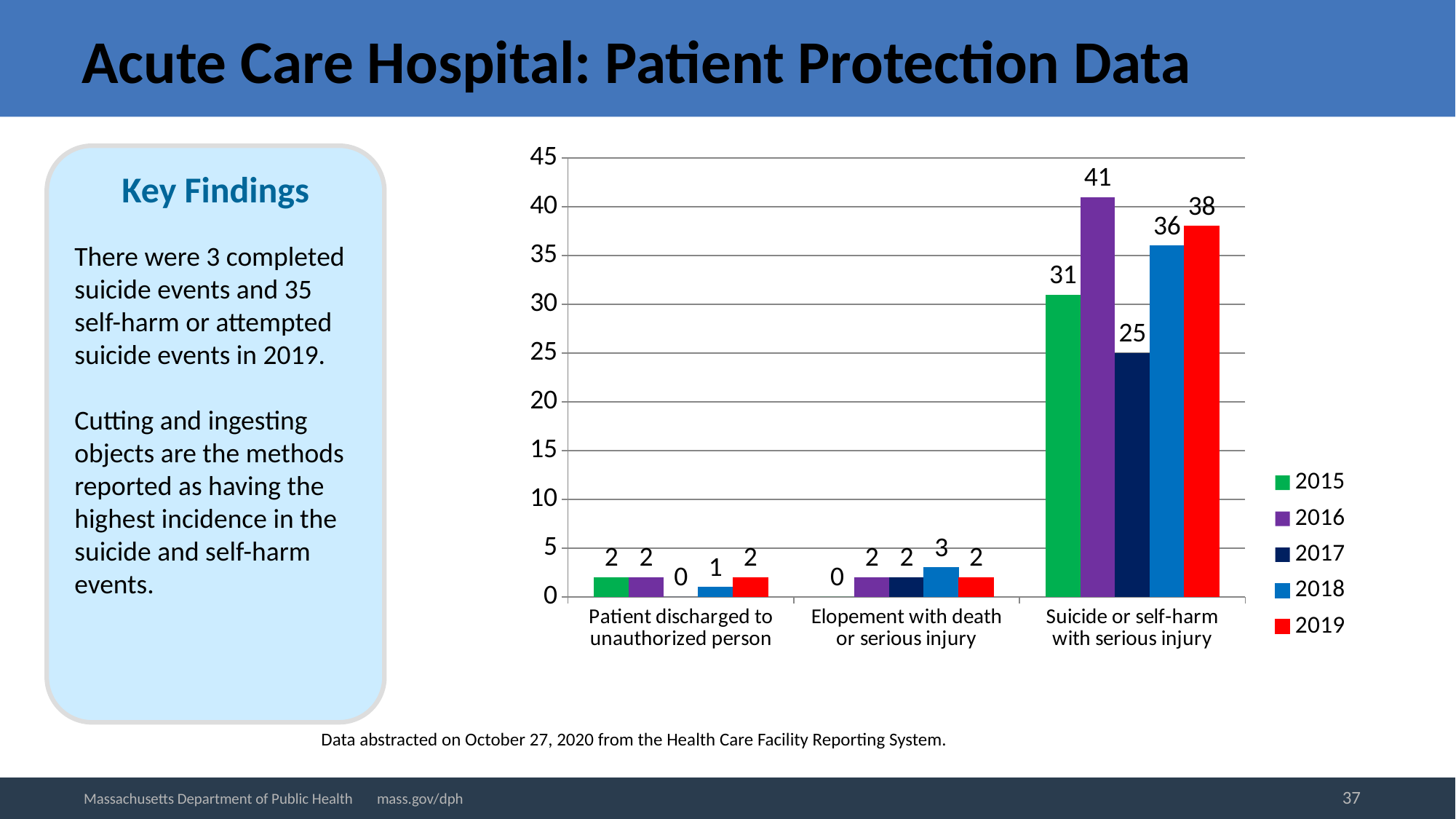
How many categories are shown on the x axis? 3 Which colour represents the 2019 series in the legend? red What is the value for 2018 in the 'Elopement with death or serious injury' category? 3 How many series does the legend list? 5 What type of chart is shown on the slide? bar chart In the 'Suicide or self-harm with serious injury' category, which is larger: the value for 2015 or the value for 2018? 2018 Which year has the lowest value in the 'Suicide or self-harm with serious injury' category? 2017 What is the value for 2017 in the 'Suicide or self-harm with serious injury' category? 25 What is the difference between the 2019 and 2018 values in the 'Suicide or self-harm with serious injury' category? 2 What is the value for 2016 in the 'Suicide or self-harm with serious injury' category? 41 Which year has the highest value in the 'Suicide or self-harm with serious injury' category? 2016 What is the value for 2017 in the 'Patient discharged to unauthorized person' category? 0